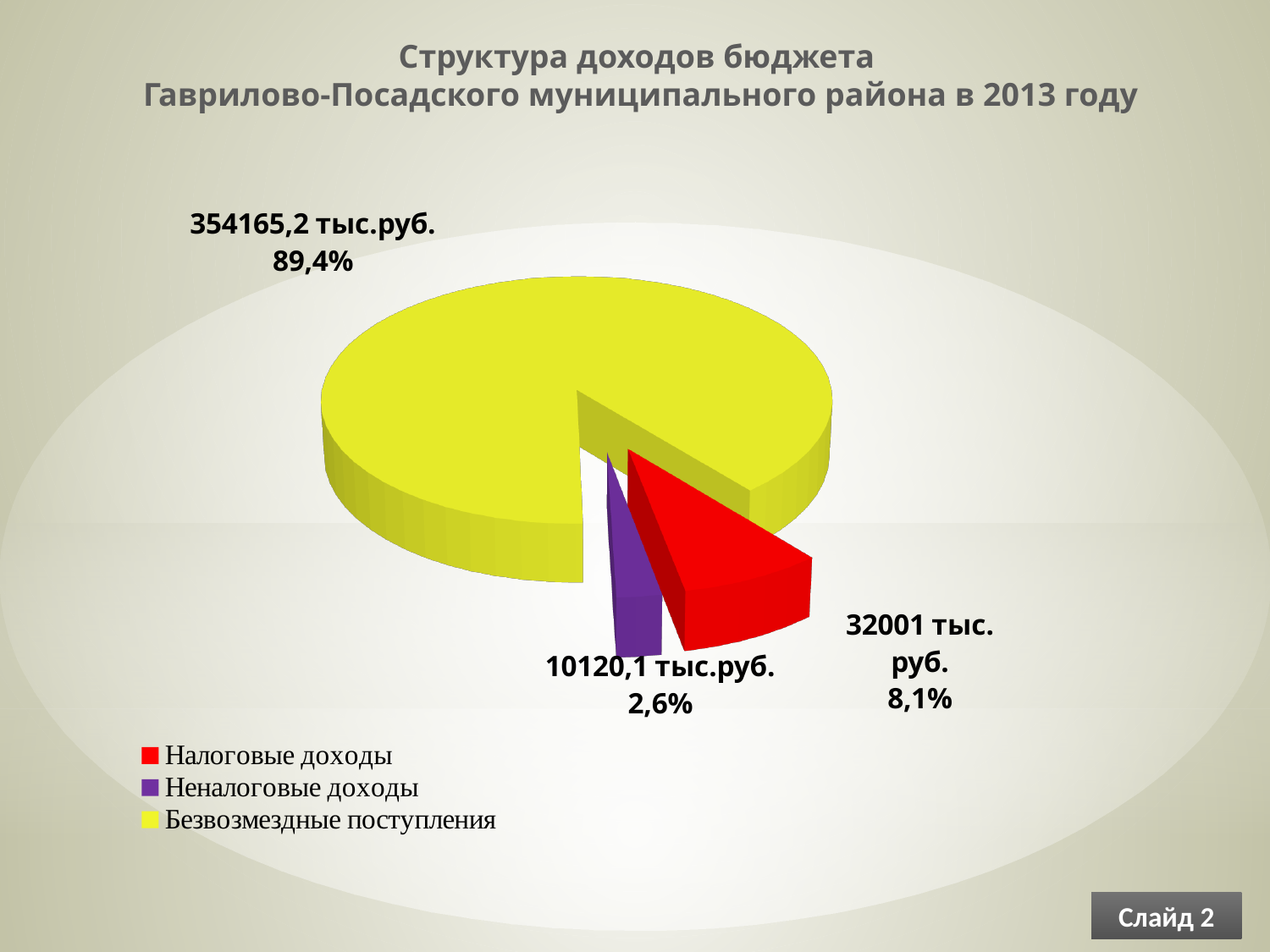
What share of the pie does Безвозмездные поступления represent? 89,4% What kind of chart is shown on the slide? Pie chart What colour is the slice for Неналоговые доходы? Purple How many categories does the pie chart have? 3 Which is larger, Налоговые доходы or Неналоговые доходы? Налоговые доходы What is the difference in percentage share between Налоговые доходы and Неналоговые доходы? 5,5% What is the title of the chart? Структура доходов бюджета Гаврилово-Посадского муниципального района в 2013 году Which category has the largest slice? Безвозмездные поступления What is the value for Неналоговые доходы? 10120,1 тыс.руб. What share of the pie does Налоговые доходы represent? 8,1% What is the value for Безвозмездные поступления? 354165,2 тыс.руб. Which category has the smallest slice? Неналоговые доходы